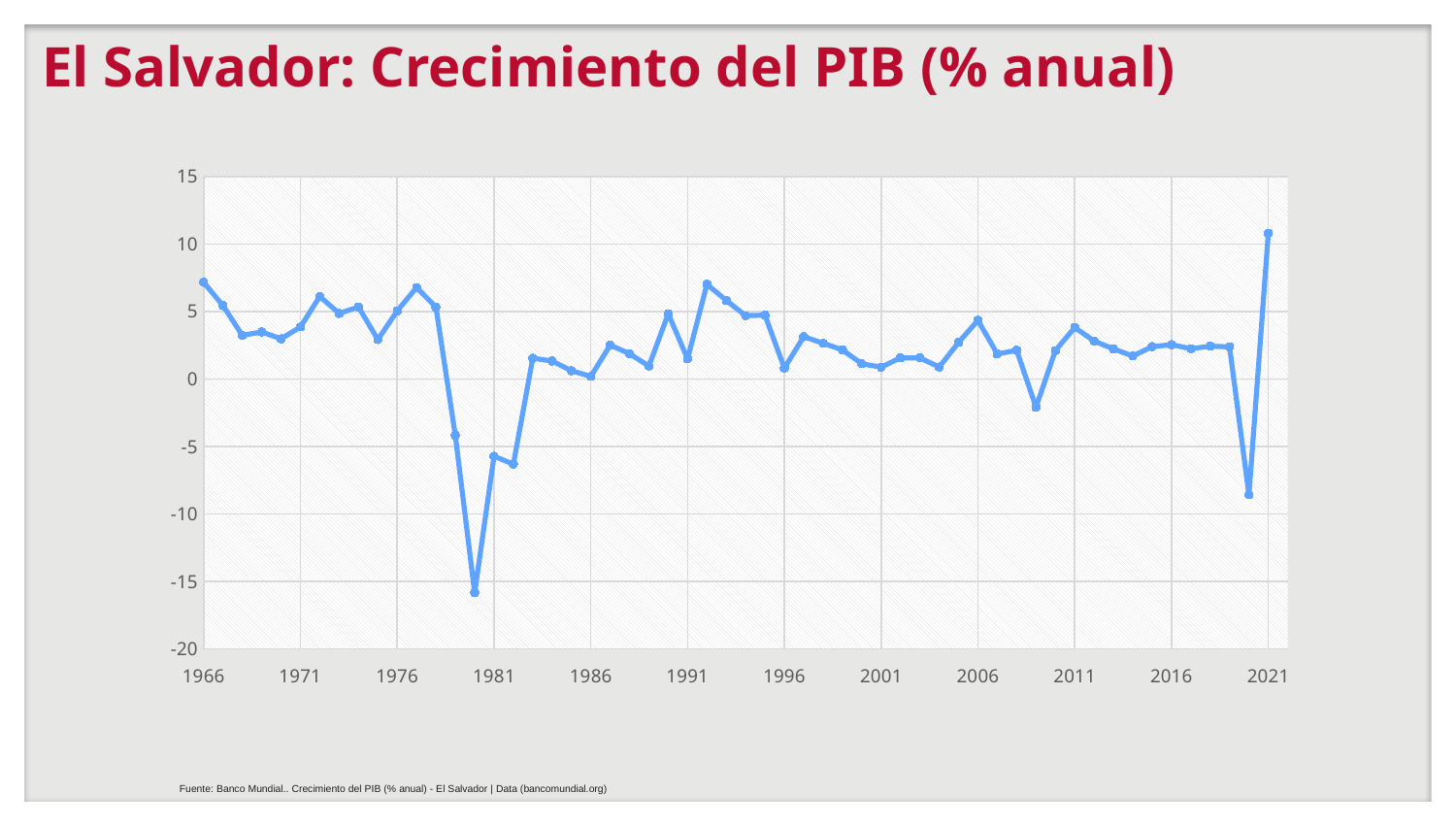
Which year has the highest GDP growth value on the chart? 2021 What kind of chart is shown on the slide? line chart Is the value for 2016 greater or less than 5? less Which year has the larger value, 1966 or 1976? 1966 Is the value for 1981 greater or less than 0? less Is the value for 2021 greater or less than 10? greater Do the values rise or fall from 1966 to 1971? fall Which year has the larger value, 2021 or 2001? 2021 What is the title of the chart? El Salvador: Crecimiento del PIB (% anual)